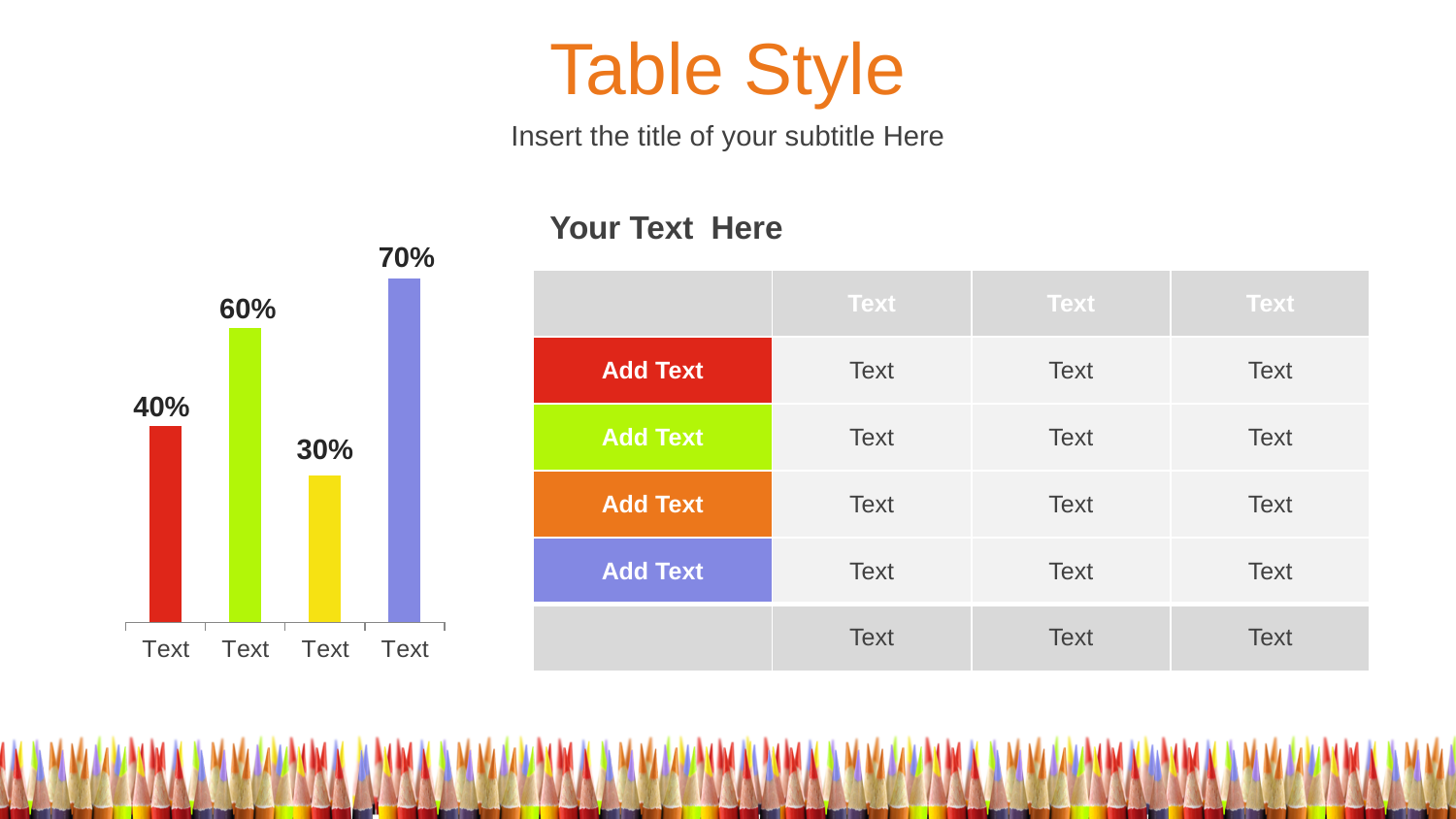
What is the value of the yellow bar (third from the left)? 30% How many bars does the chart show? 4 What is the value of the green bar (second from the left)? 60% What type of chart is shown on the left of the slide? bar chart Which bar has the lowest value? the yellow bar (third from the left), 30% What is the value of the blue bar (fourth from the left)? 70% What is the value of the red bar (first from the left)? 40% Which bar has the highest value? the blue bar (fourth from the left), 70% What is the difference between the green bar and the yellow bar? 30% Which is larger, the value of the red bar or the value of the green bar? the green bar What label is shown under each bar on the x axis? Text What is the difference between the highest and lowest bar values? 40%